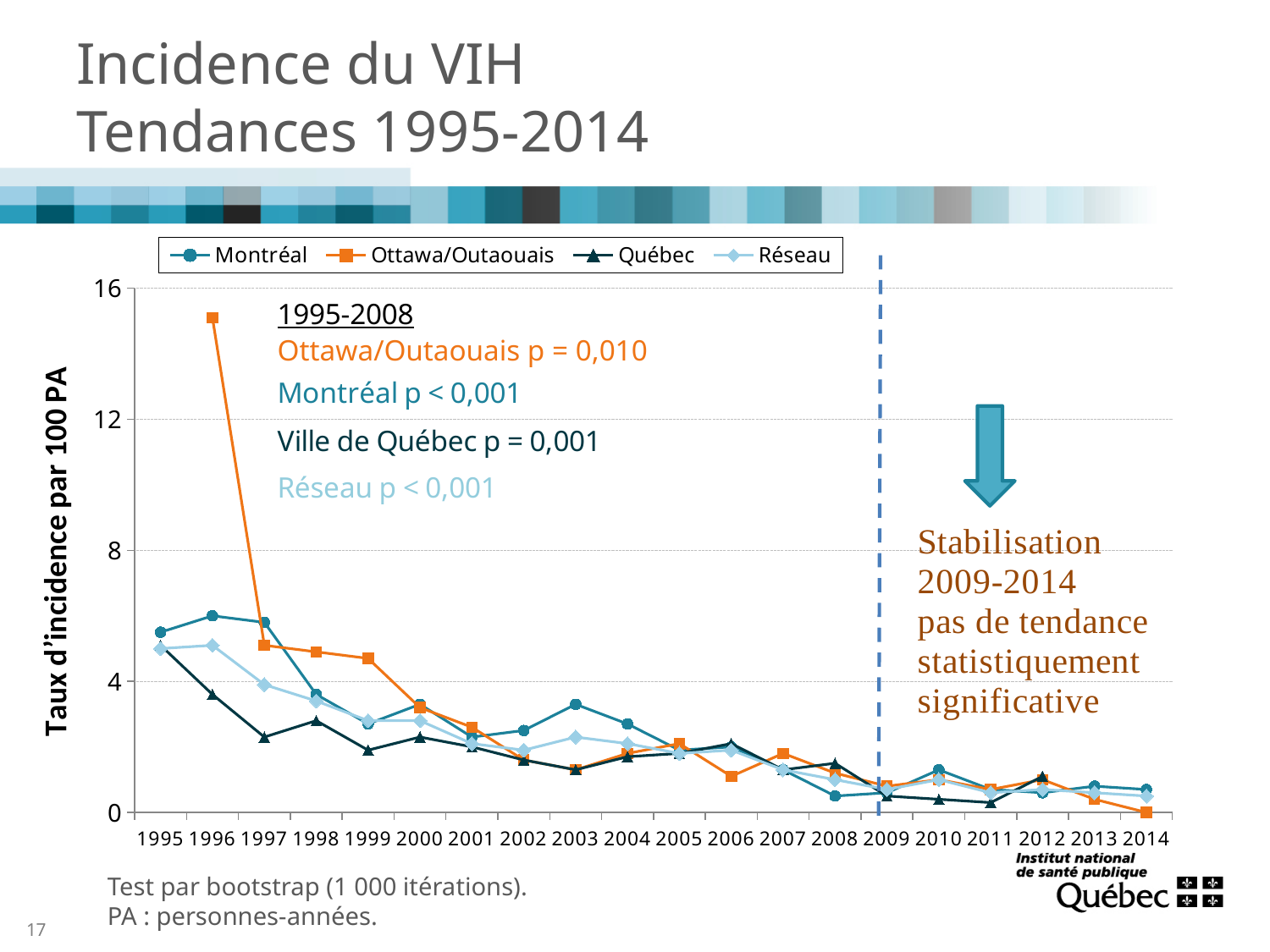
In which year does the Ottawa/Outaouais series reach its highest value? 1996 Is the value for Ottawa/Outaouais in 1996 greater or less than 12? greater Is the value for Montréal in 1996 greater or less than 4? greater How many series does the legend list? 4 How many years are plotted along the x axis? 20 Is the value for Ottawa/Outaouais in 2014 greater or less than 4? less In 1997, which is higher: Montréal or Québec? Montréal What is the title of the y axis? Taux d'incidence par 100 PA Which series has the highest value in 1996? Ottawa/Outaouais What kind of chart is shown on the slide? line chart Does the Ottawa/Outaouais series rise or fall overall from 1995 to 2014? fall